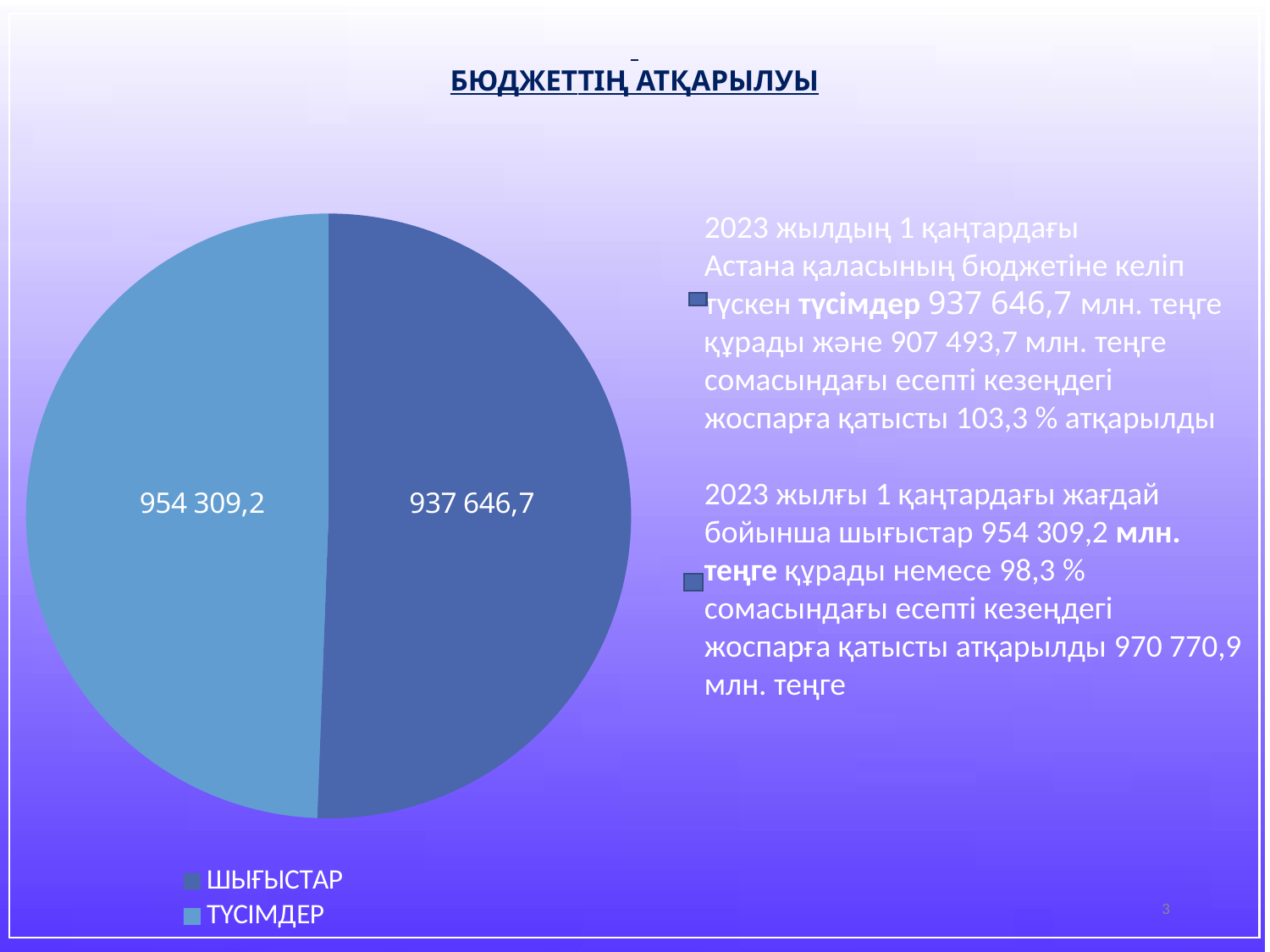
What is the largest value printed on the pie chart? 954 309,2 Which slice of the pie chart has the larger printed value, the light blue one or the dark blue one? the light blue one What is the first entry listed in the pie chart's legend? ШЫҒЫСТАР What value is printed on the light blue slice on the left side of the pie chart? 954 309,2 How many entries does the pie chart's legend list? 2 What is the title of the slide containing the pie chart? БЮДЖЕТТІҢ АТҚАРЫЛУЫ What is the difference between the two values printed on the pie chart, 954 309,2 and 937 646,7? 16 662,5 What kind of chart is shown on the slide? pie chart What is the smallest value printed on the pie chart? 937 646,7 How many slices does the pie chart have? 2 What is the total of the two values printed on the pie chart? 1 891 955,9 What value is printed on the dark blue slice on the right side of the pie chart? 937 646,7